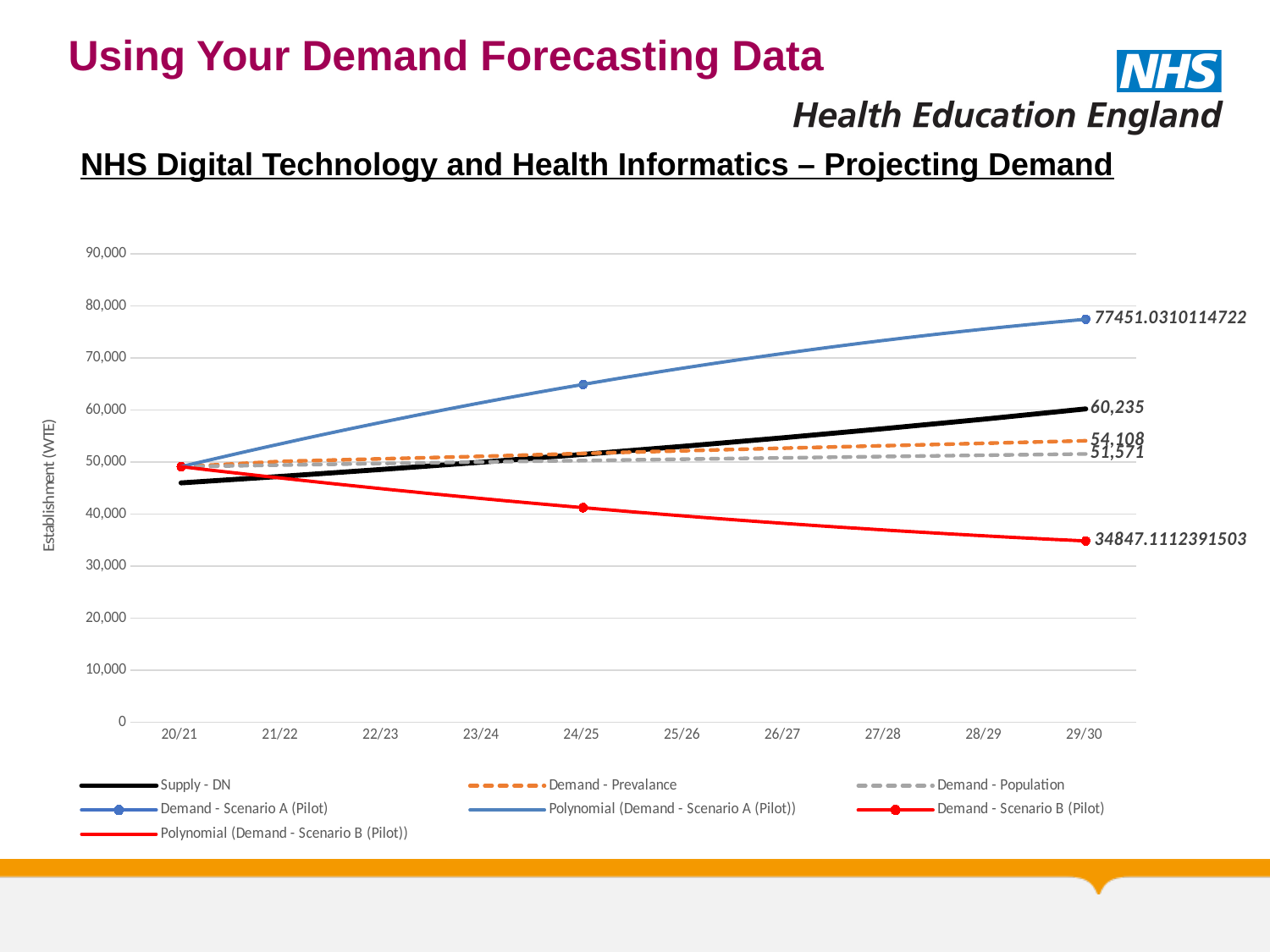
What is the value of Supply - DN at 29/30? 60,235 What is the difference between Supply - DN and Demand - Prevalance at 29/30? 6,127 What value is labelled for Demand - Scenario A (Pilot) at 29/30? 77451.0310114722 Is the value for Demand - Scenario A (Pilot) at 24/25 greater or less than 60,000? greater What is the value of Demand - Prevalance at 29/30? 54,108 Which series has the highest value at 29/30? Demand - Scenario A (Pilot) How many series does the legend list? 7 Does the Demand - Scenario B (Pilot) line rise or fall from 20/21 to 29/30? fall What kind of chart is shown on the slide? line chart What value is labelled for Demand - Scenario B (Pilot) at 29/30? 34847.1112391503 What is the value of Demand - Population at 29/30? 51,571 Which series has the lowest value at 29/30? Demand - Scenario B (Pilot)